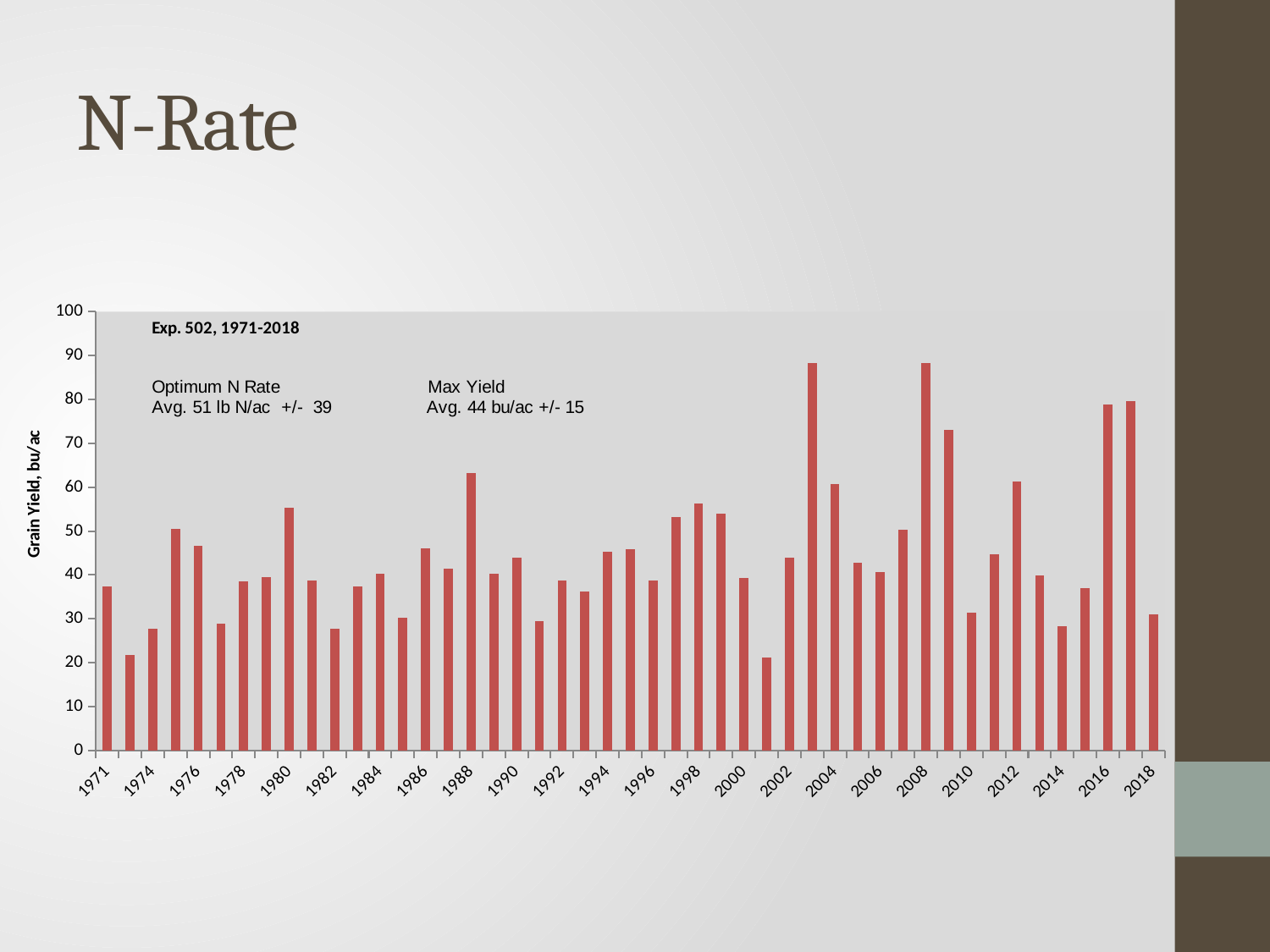
Is the grain yield for 1982 greater or less than 30? less What experiment and year range does the text inside the chart identify? Exp. 502, 1971-2018 What is the label on the vertical axis of the chart? Grain Yield, bu/ac Is the grain yield for 2008 greater or less than 80? greater Which year has the higher grain yield, 2008 or 2014? 2008 Which year has the higher grain yield, 2016 or 2010? 2016 Is the grain yield for 2014 greater or less than 30? less What kind of chart is shown on the slide? bar chart Which year has the higher grain yield, 1988 or 1982? 1988